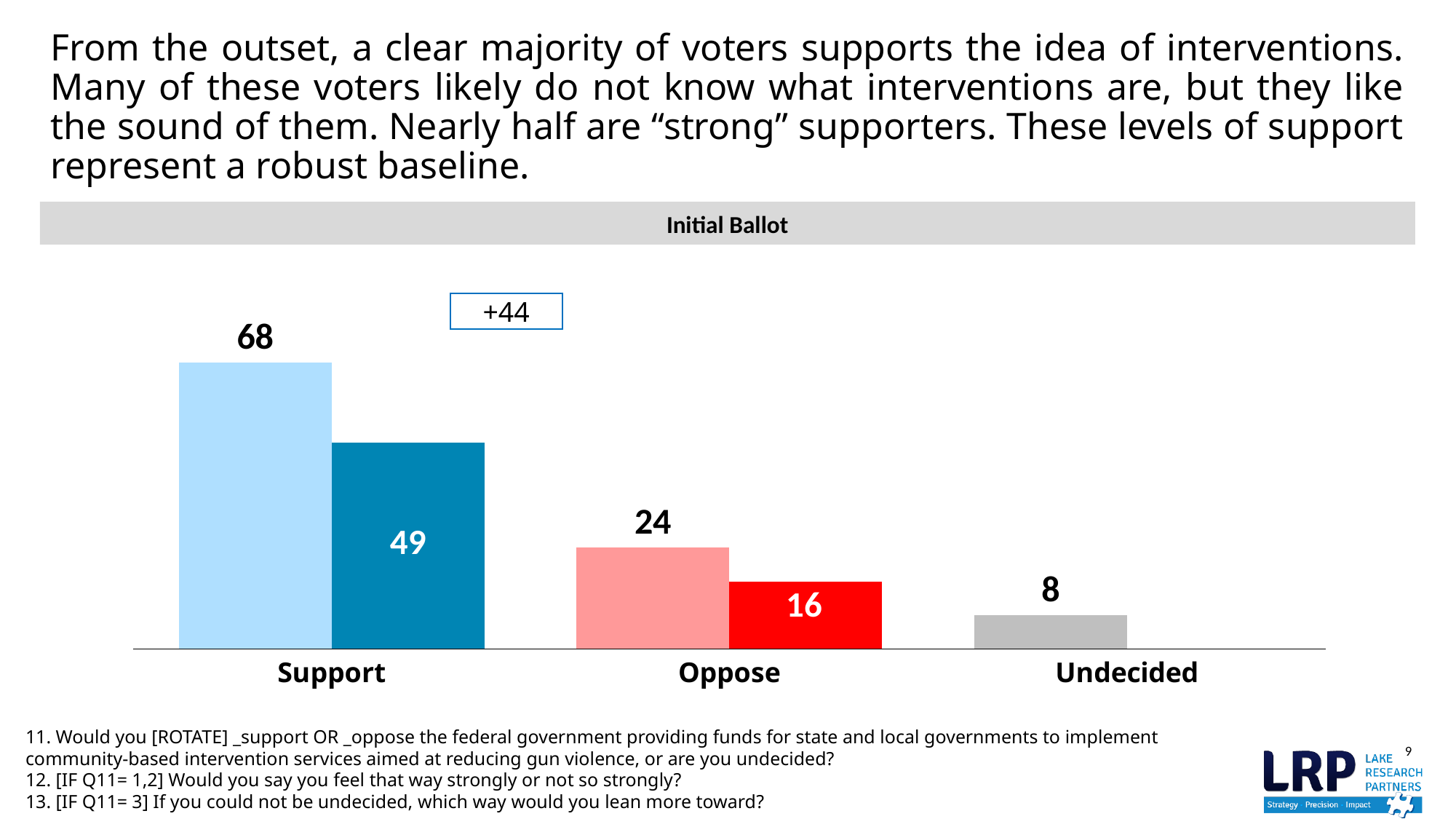
What is the total Support value shown on the chart? 68 Which category has the highest value? Support What is the total Oppose value shown on the chart? 24 What net margin is shown in the box above the bars? +44 What is the difference between total Support (68) and total Oppose (24)? 44 Which is larger, the strong support value or the total Oppose value? Strong support (49) What is the strong support value (the darker blue bar) in the Support category? 49 What is the value for Undecided? 8 What kind of chart is shown on the slide? Bar chart How many categories are shown on the x axis? 3 Which category has the lowest value? Undecided What is the strong oppose value (the darker red bar) in the Oppose category? 16